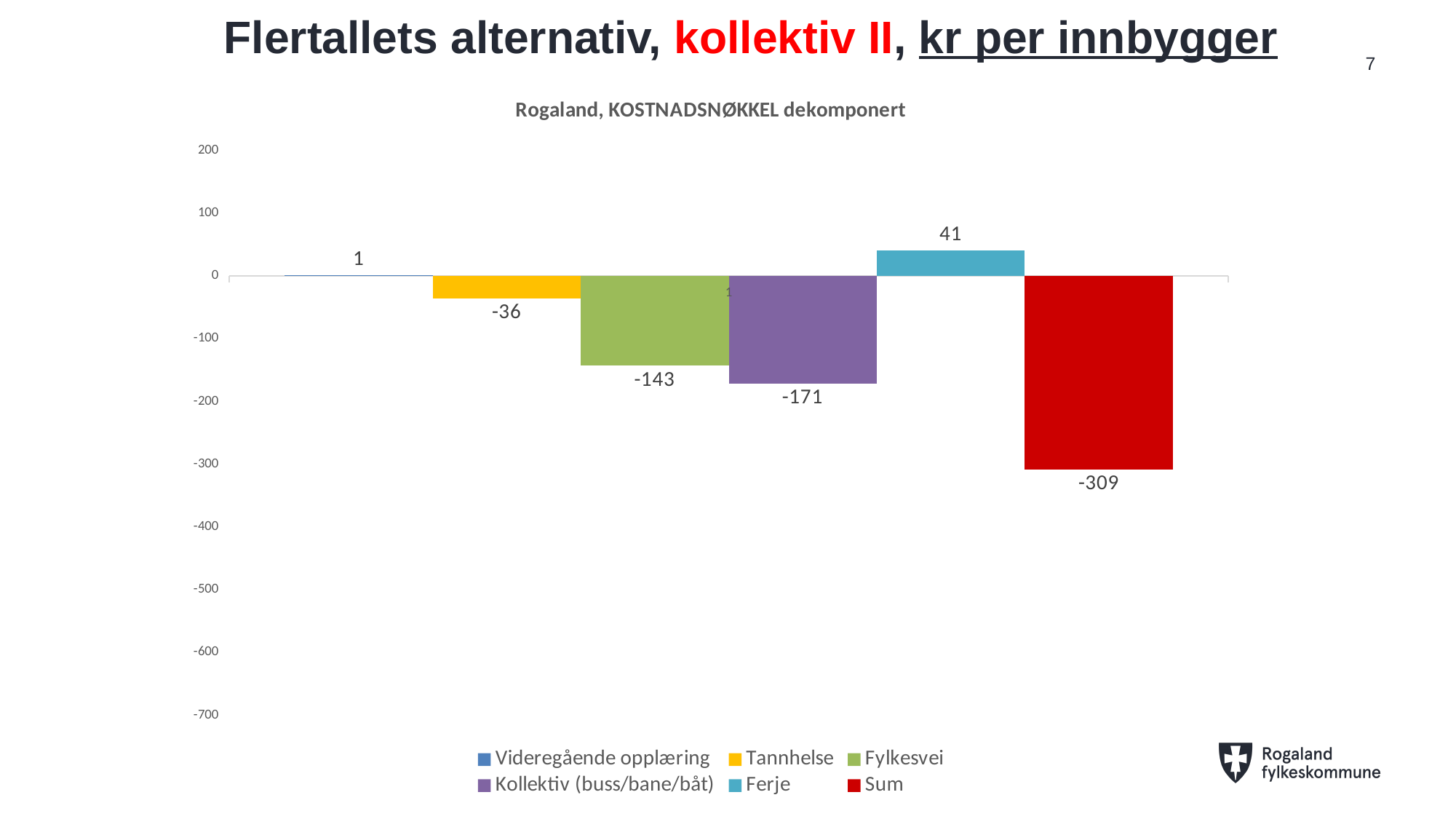
What is the value for Ferje? 41 What is the value for Sum? -309 Which is larger, the value for Tannhelse or the value for Fylkesvei? Tannhelse What is the value for Kollektiv (buss/bane/båt)? -171 What is the value for Fylkesvei? -143 What kind of chart is shown on the slide? Bar chart What is the title of the chart? Rogaland, KOSTNADSNØKKEL dekomponert What is the difference between the values for Kollektiv (buss/bane/båt) and Fylkesvei? 28 How many series does the legend list? 6 What is the value for Tannhelse? -36 Which series has the highest value? Ferje Which series has the lowest value? Sum